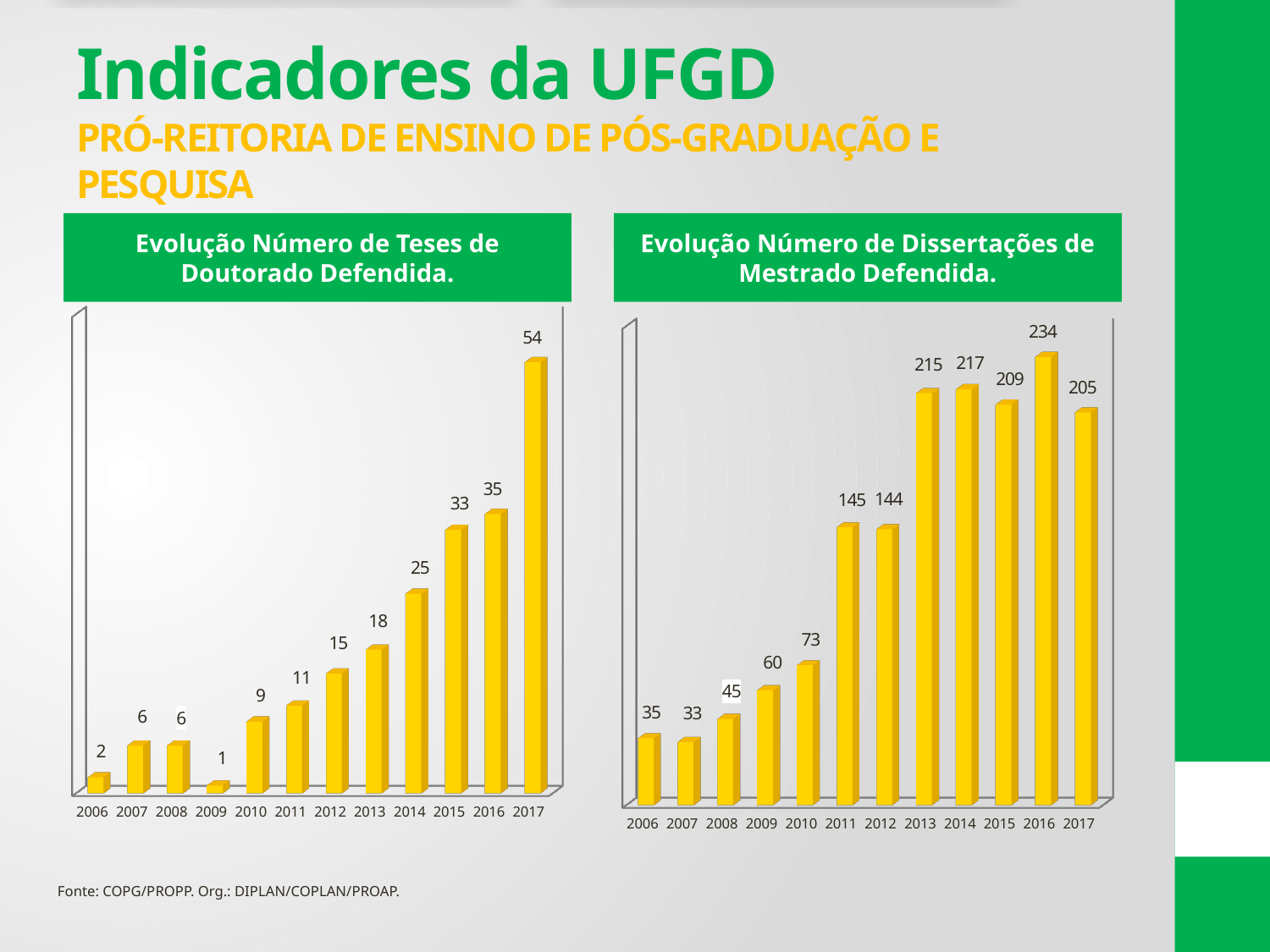
In the chart 'Evolução Número de Teses de Doutorado Defendida.', what is the value for 2013? 18 In the chart 'Evolução Número de Teses de Doutorado Defendida.', what is the value for 2017? 54 In the chart 'Evolução Número de Dissertações de Mestrado Defendida.', what is the difference between the values for 2016 and 2017? 29 In the chart 'Evolução Número de Teses de Doutorado Defendida.', how many years are shown on the x axis? 12 In the chart 'Evolução Número de Dissertações de Mestrado Defendida.', what is the value for 2011? 145 In the chart 'Evolução Número de Dissertações de Mestrado Defendida.', which year has the highest value? 2016 In the chart 'Evolução Número de Dissertações de Mestrado Defendida.', which is larger, the value for 2013 or the value for 2015? 2013 In the chart 'Evolução Número de Teses de Doutorado Defendida.', what is the difference between the values for 2017 and 2016? 19 In the chart 'Evolução Número de Dissertações de Mestrado Defendida.', which year has the lowest value? 2007 In the chart 'Evolução Número de Teses de Doutorado Defendida.', do the values generally rise or fall from 2009 to 2017? Rise In the chart 'Evolução Número de Teses de Doutorado Defendida.', which year has the lowest value? 2009 What kind of chart is 'Evolução Número de Dissertações de Mestrado Defendida.'? Bar chart